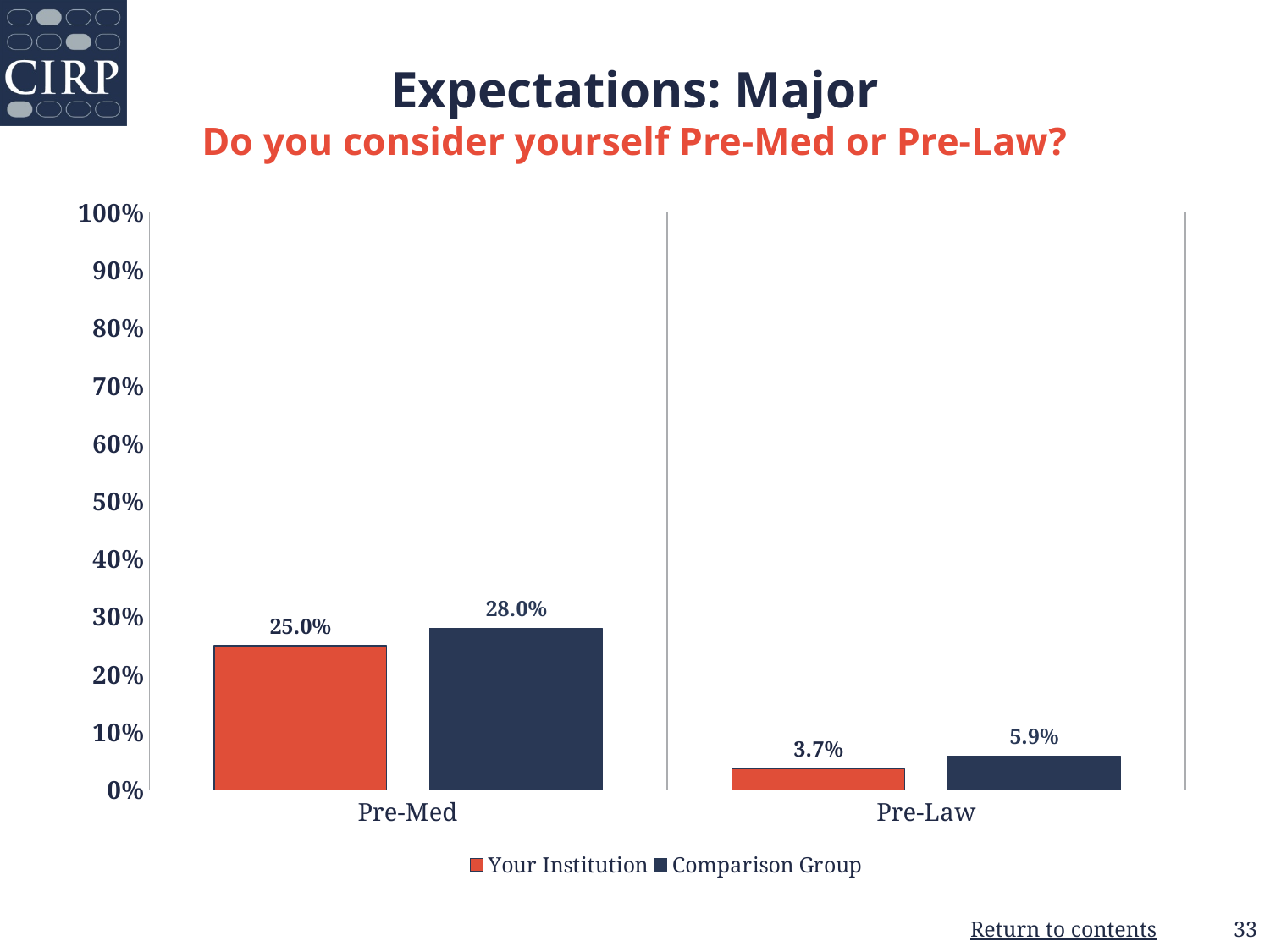
Which category has the lowest Your Institution value? Pre-Law What is the value for Comparison Group in the Pre-Law category? 5.9% Which category has the highest Comparison Group value? Pre-Med What is the difference between the Comparison Group and Your Institution values for Pre-Med? 3.0% What kind of chart is shown on the slide? bar chart Is the Comparison Group value for Pre-Med greater or less than 30%? less What is the value for Your Institution in the Pre-Law category? 3.7% What is the value for Your Institution in the Pre-Med category? 25.0% What is the difference between the Comparison Group and Your Institution values for Pre-Law? 2.2% How many series does the legend list? 2 Which is larger for Pre-Law: Your Institution or Comparison Group? Comparison Group How many categories are shown on the x axis? 2